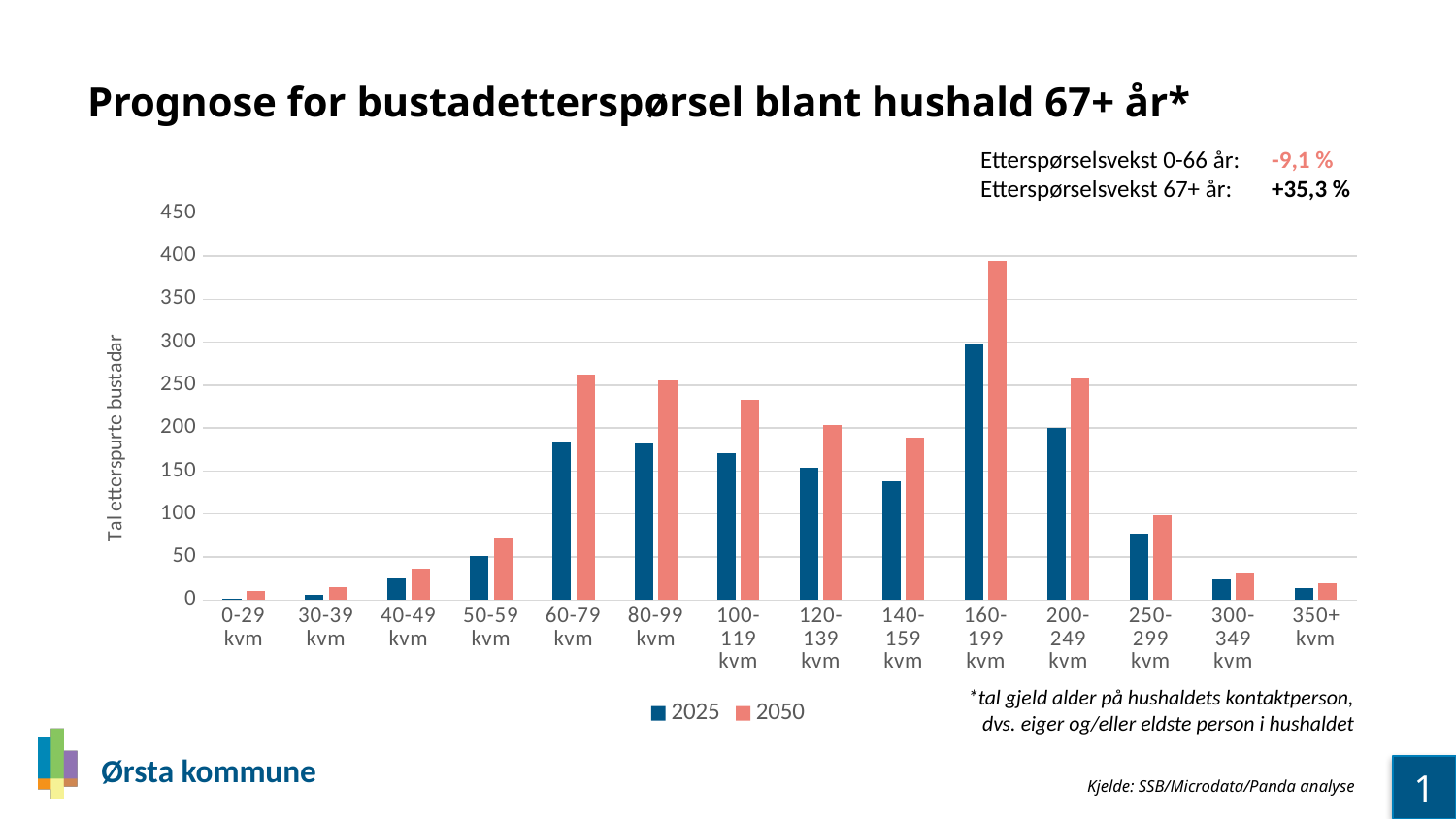
Which size category has the lowest value for the 2025 series? 0-29 kvm Is the 2050 value for 160-199 kvm greater or less than 350? greater Is the 2025 value for 160-199 kvm greater or less than 250? greater How many series does the legend list? 2 Which size category has the highest value for the 2050 series? 160-199 kvm What kind of chart is shown on the slide? bar chart How many size categories (kvm groups) are shown on the x axis? 14 What is the label of the y axis? Tal etterspurte bustadar Which size category has the highest value for the 2025 series? 160-199 kvm Is the 2050 value for 60-79 kvm greater or less than 200? greater For 160-199 kvm, which series has the larger value, 2025 or 2050? 2050